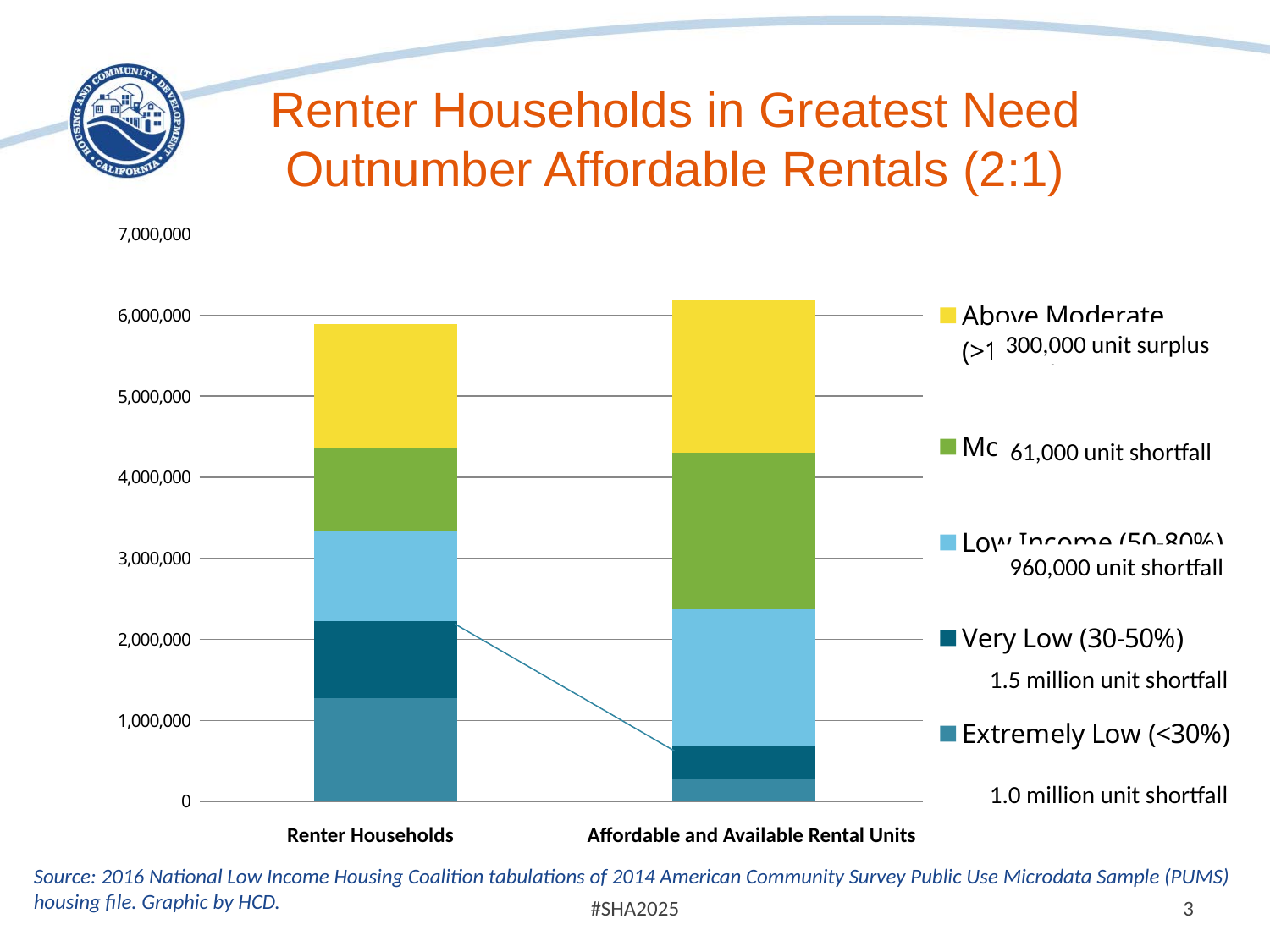
How many series does the chart's legend list? 5 Is the total height of the Affordable and Available Rental Units bar greater or less than 6,000,000? greater Which bar is taller overall, Renter Households or Affordable and Available Rental Units? Affordable and Available Rental Units Is the Extremely Low (<30%) segment of the Renter Households bar greater or less than 1,000,000? greater What is the highest value shown on the chart's vertical axis? 7,000,000 Is the Extremely Low (<30%) segment of the Affordable and Available Rental Units bar greater or less than 1,000,000? less What kind of chart is shown on the slide? Stacked bar chart Which category has the larger Extremely Low (<30%) segment, Renter Households or Affordable and Available Rental Units? Renter Households How many categories are shown on the x axis of the chart? 2 According to the annotation next to the legend, what is the unit shortfall for Very Low (30-50%) households? 1.5 million unit shortfall